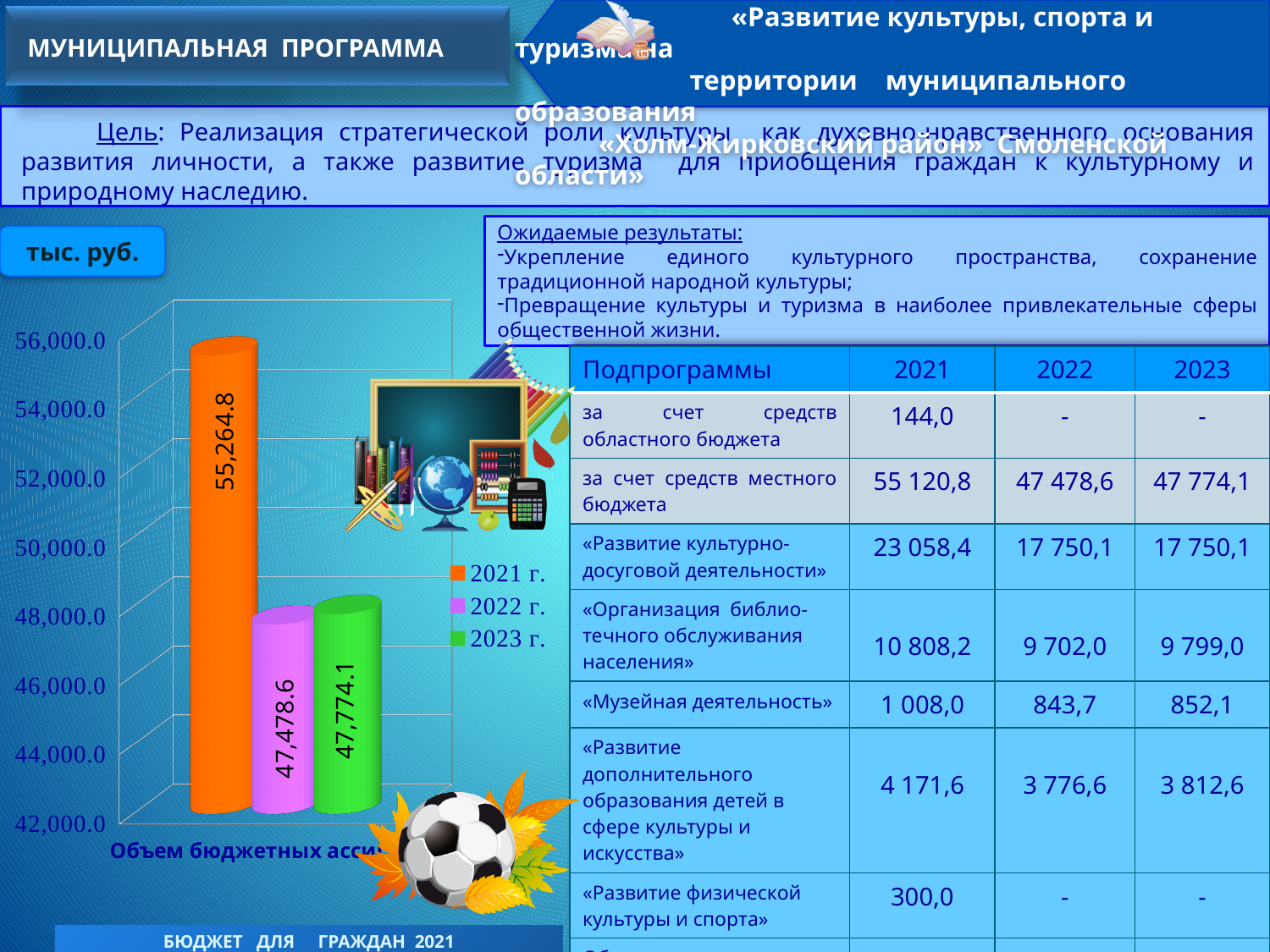
What is the difference between the values for 2021 г. and 2022 г.? 7,786.2 What kind of chart is shown on the slide? bar chart Which year has the highest bar in the chart? 2021 г. What is the value of the bar for 2021 г.? 55,264.8 Is the value for 2021 г. greater or less than 54,000.0? greater Which year has the lowest bar in the chart? 2022 г. How many bars are plotted in the chart? 3 What is the value of the bar for 2022 г.? 47,478.6 What is the difference between the values for 2023 г. and 2022 г.? 295.5 What is the value of the bar for 2023 г.? 47,774.1 How many entries does the chart legend list? 3 Which is larger, the value for 2022 г. or the value for 2023 г.? 2023 г.